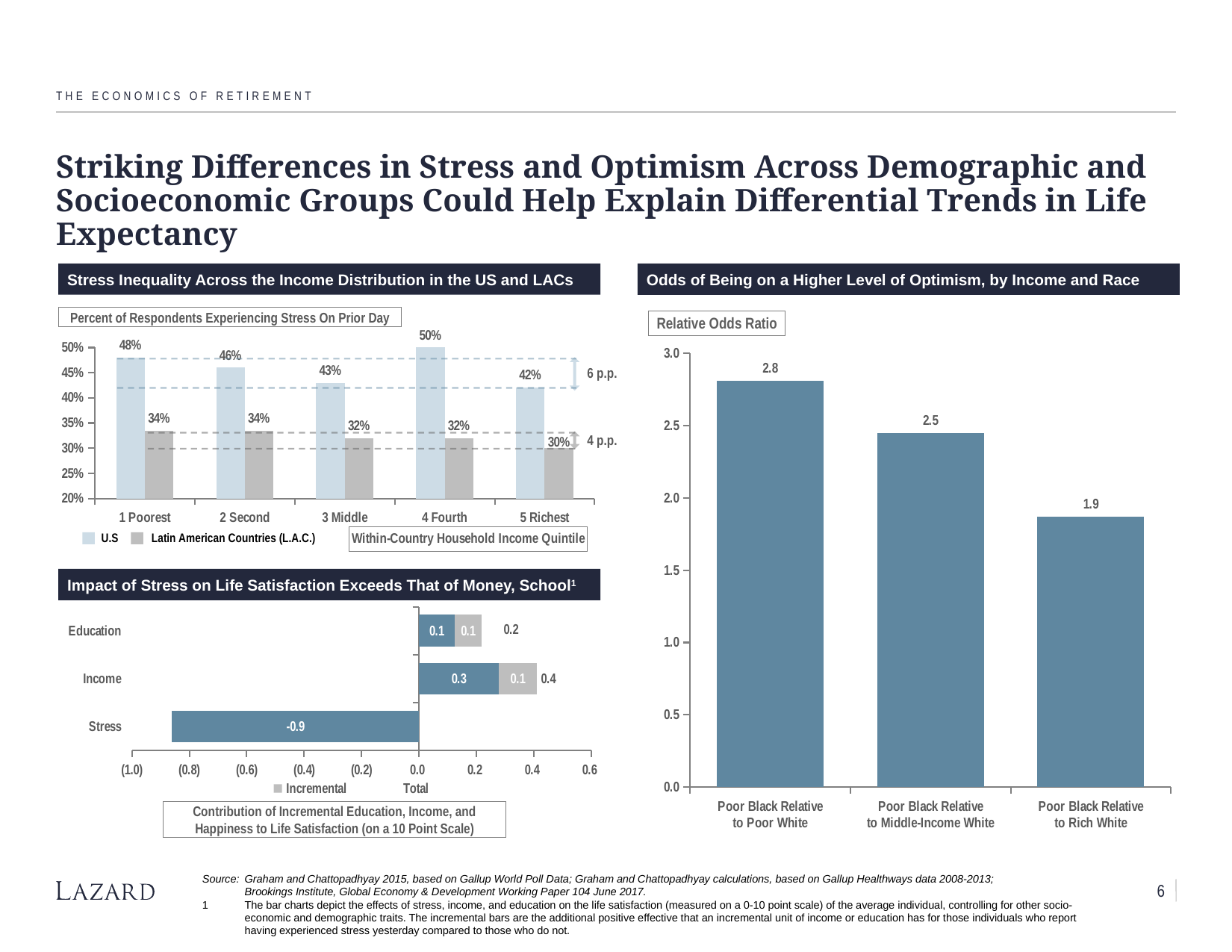
In the 'Odds of Being on a Higher Level of Optimism, by Income and Race' chart, what is the difference between the values for Poor Black Relative to Poor White and Poor Black Relative to Rich White? 0.9 In the 'Stress Inequality Across the Income Distribution in the US and LACs' chart, what is the value for the U.S. in the 4 Fourth quintile? 50% In the 'Odds of Being on a Higher Level of Optimism, by Income and Race' chart, what is the relative odds ratio for Poor Black Relative to Middle-Income White? 2.5 In the 'Impact of Stress on Life Satisfaction Exceeds That of Money, School' chart, what is the value labelled for Stress? -0.9 In the 'Stress Inequality Across the Income Distribution in the US and LACs' chart, which income quintile has the highest U.S. value? 4 Fourth In the 'Stress Inequality Across the Income Distribution in the US and LACs' chart, how many series does the legend list? 2 In the 'Stress Inequality Across the Income Distribution in the US and LACs' chart, how many income quintiles are shown on the x axis? 5 In the 'Impact of Stress on Life Satisfaction Exceeds That of Money, School' chart, what is the total value shown for Income? 0.4 In the 'Stress Inequality Across the Income Distribution in the US and LACs' chart, what is the value for Latin American Countries in the 5 Richest quintile? 30% In the 'Impact of Stress on Life Satisfaction Exceeds That of Money, School' chart, what kind of chart is shown? Horizontal stacked bar chart In the 'Odds of Being on a Higher Level of Optimism, by Income and Race' chart, which category has the lowest relative odds ratio? Poor Black Relative to Rich White In the 'Stress Inequality Across the Income Distribution in the US and LACs' chart, what is the difference between the U.S. and Latin American Countries values in the 1 Poorest quintile? 14 percentage points